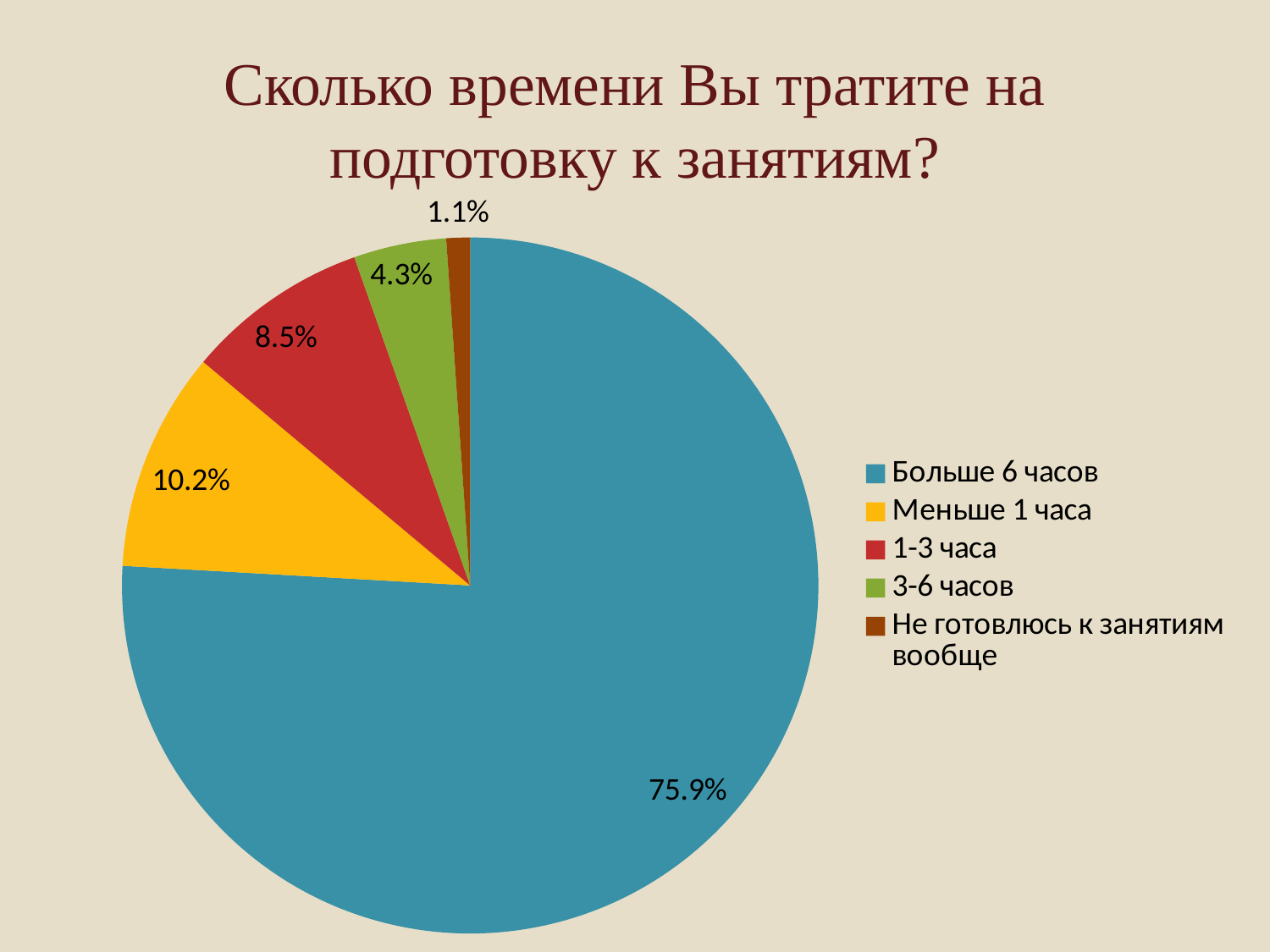
What share of the pie does "Не готовлюсь к занятиям вообще" have? 1.1% Which category has the smallest slice of the pie? Не готовлюсь к занятиям вообще What is the difference between the shares of "Меньше 1 часа" and "1-3 часа"? 1.7% Which is larger, the share for "3-6 часов" or the share for "1-3 часа"? 1-3 часа What kind of chart is shown on the slide? Pie chart What share of the pie does "1-3 часа" have? 8.5% What is the title of the chart? Сколько времени Вы тратите на подготовку к занятиям? How many categories does the pie chart have? 5 What share of the pie does "Меньше 1 часа" have? 10.2% Which category has the largest slice of the pie? Больше 6 часов What share of the pie does "Больше 6 часов" have? 75.9% What share of the pie does "3-6 часов" have? 4.3%